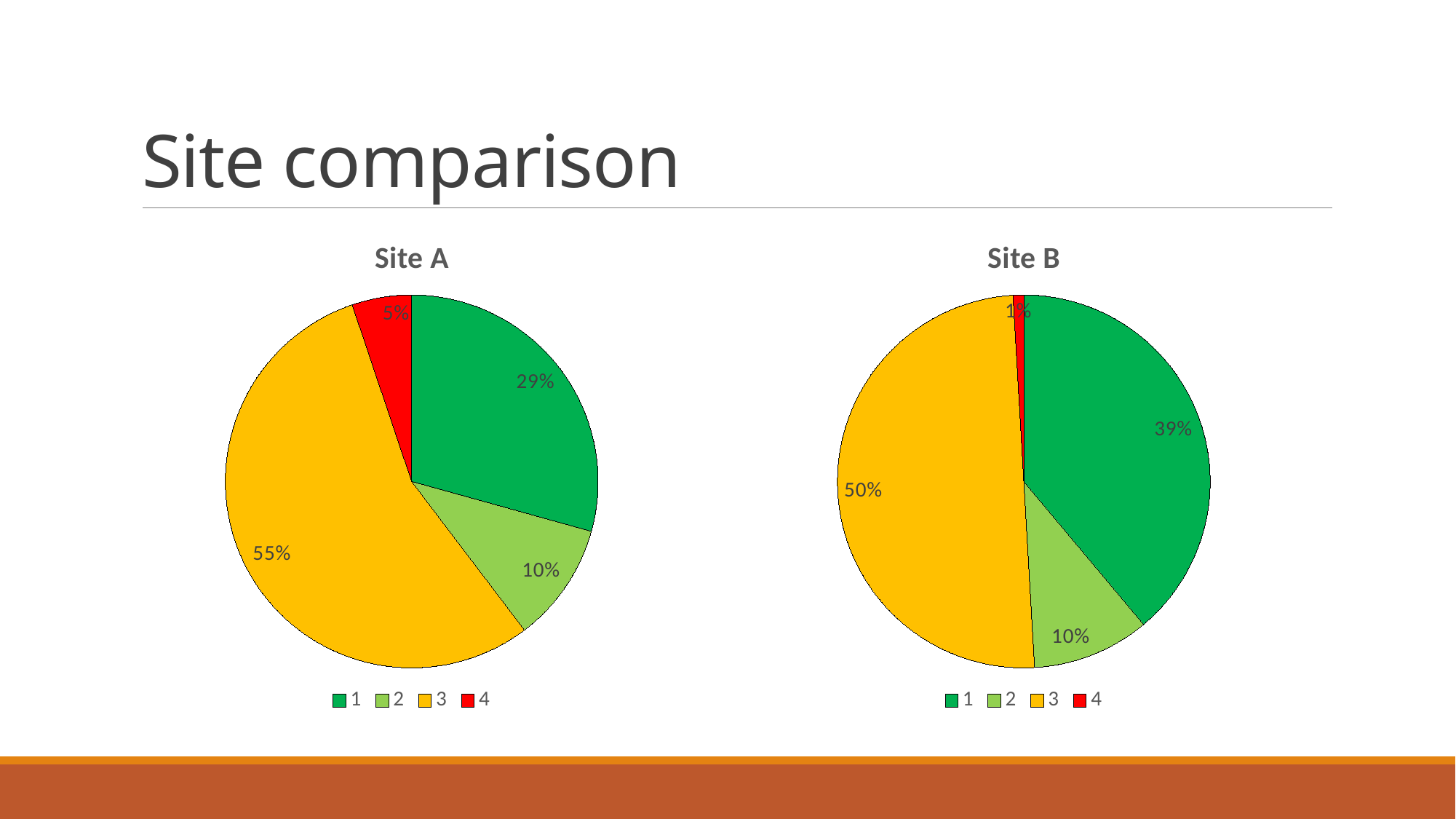
What is the difference between the share of category 1 in the Site B chart and the share of category 1 in the Site A chart? 10% Which is larger: the share of category 3 in the Site A chart or the share of category 3 in the Site B chart? Site A In the Site B chart, what share does category 3 have? 50% In the Site B chart, what share does category 4 have? 1% In the Site B chart, which category has the smallest slice? 4 In the Site B chart, what share does category 1 have? 39% In the Site A chart, what share does category 4 have? 5% In the Site A chart, which category has the largest slice? 3 In the Site A chart, what share does category 1 have? 29% What kind of chart is the Site B chart? Pie chart In the Site A chart, what share does category 3 have? 55% How many categories does the legend of the Site A chart list? 4